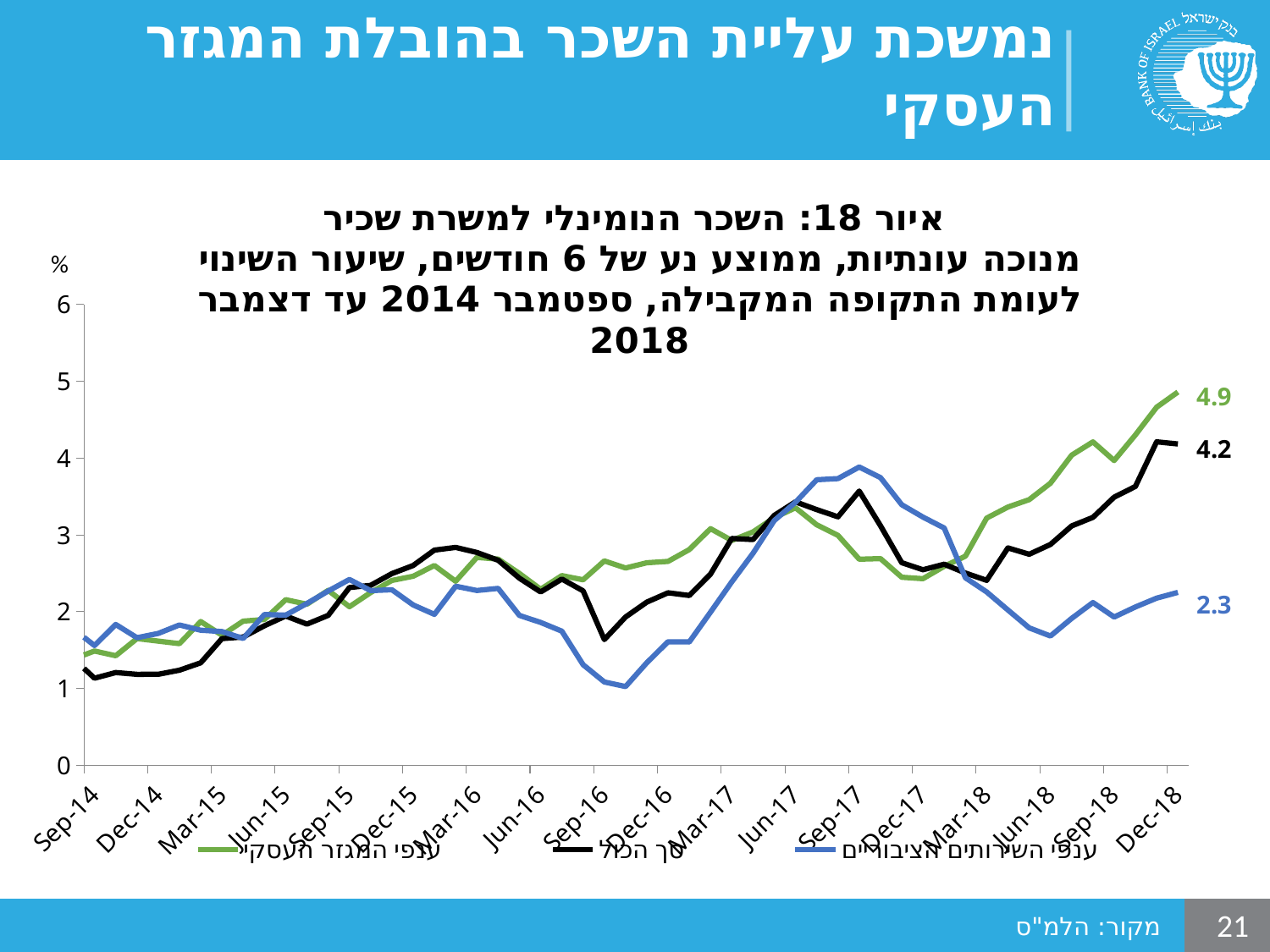
What is the value of the ענפי המגזר העסקי (green) series at Dec-18? 4.9 Which series has the highest value at Dec-18? ענפי המגזר העסקי What is the difference between the ענפי המגזר העסקי value and the ענפי השירותים הציבוריים value at Dec-18? 2.6 What is the difference between the ענפי המגזר העסקי value and the סך הכל value at Dec-18? 0.7 What kind of chart is shown on the slide? line chart Does the ענפי המגזר העסקי (green) series overall rise or fall from Sep-14 to Dec-18? rise Which series has the lowest value at Dec-18? ענפי השירותים הציבוריים Is the value of the ענפי השירותים הציבוריים (blue) series at Sep-16 greater or less than 2? less What is the value of the ענפי השירותים הציבוריים (blue) series at Dec-18? 2.3 What unit is shown on the y axis? % How many series does the legend list? 3 What is the value of the סך הכל (black) series at Dec-18? 4.2